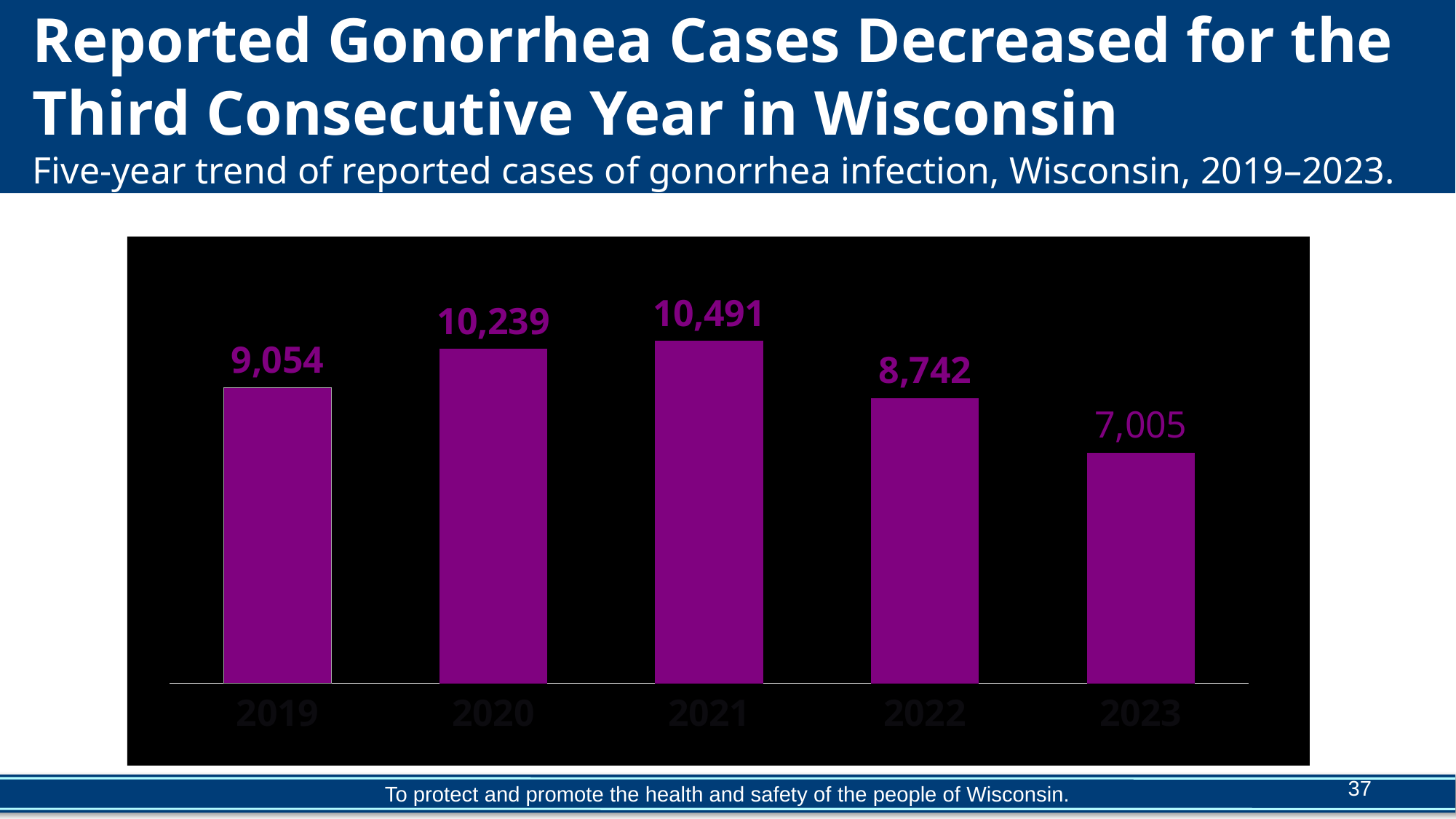
Which year has the highest number of reported cases? 2021 Which year has the lowest number of reported cases? 2023 What is the difference between the 2020 and 2019 values? 1,185 Do the values rise or fall from 2021 to 2023? Fall How many years are shown on the chart? 5 What is the value shown for 2021? 10,491 What type of chart is shown on the slide? Bar chart Which year has more reported cases, 2020 or 2022? 2020 What is the difference between the 2021 and 2023 values? 3,486 What is the value shown for 2023? 7,005 How many reported gonorrhea cases were there in Wisconsin in 2019? 9,054 What is the value shown for 2022? 8,742